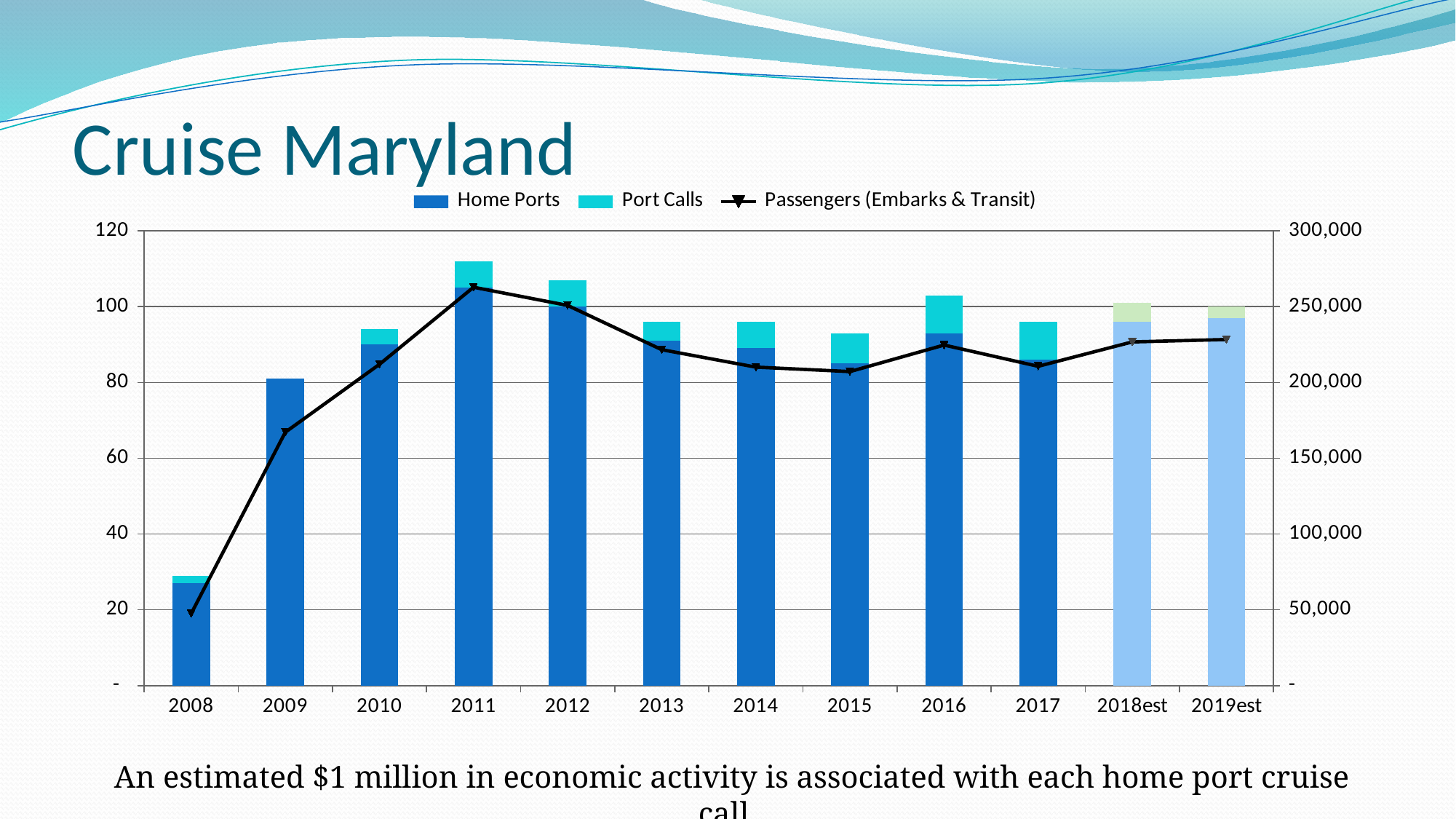
In which year does the Passengers (Embarks & Transit) line reach its highest point? 2011 How many series does the legend list? 3 Which year has the shortest stacked bar? 2008 In which year is the Passengers (Embarks & Transit) line at its lowest? 2008 Is the Passengers (Embarks & Transit) value for 2009 greater or less than 150,000? greater Which year has the taller stacked bar, 2009 or 2010? 2010 Is the total stacked bar for 2011 greater or less than 100? greater Which year has the tallest stacked bar? 2011 Is the total stacked bar for 2008 greater or less than 40? less Does the Passengers (Embarks & Transit) line rise or fall from 2008 to 2011? rise What kind of chart is this? Stacked bar chart with a line How many years are shown on the x axis? 12